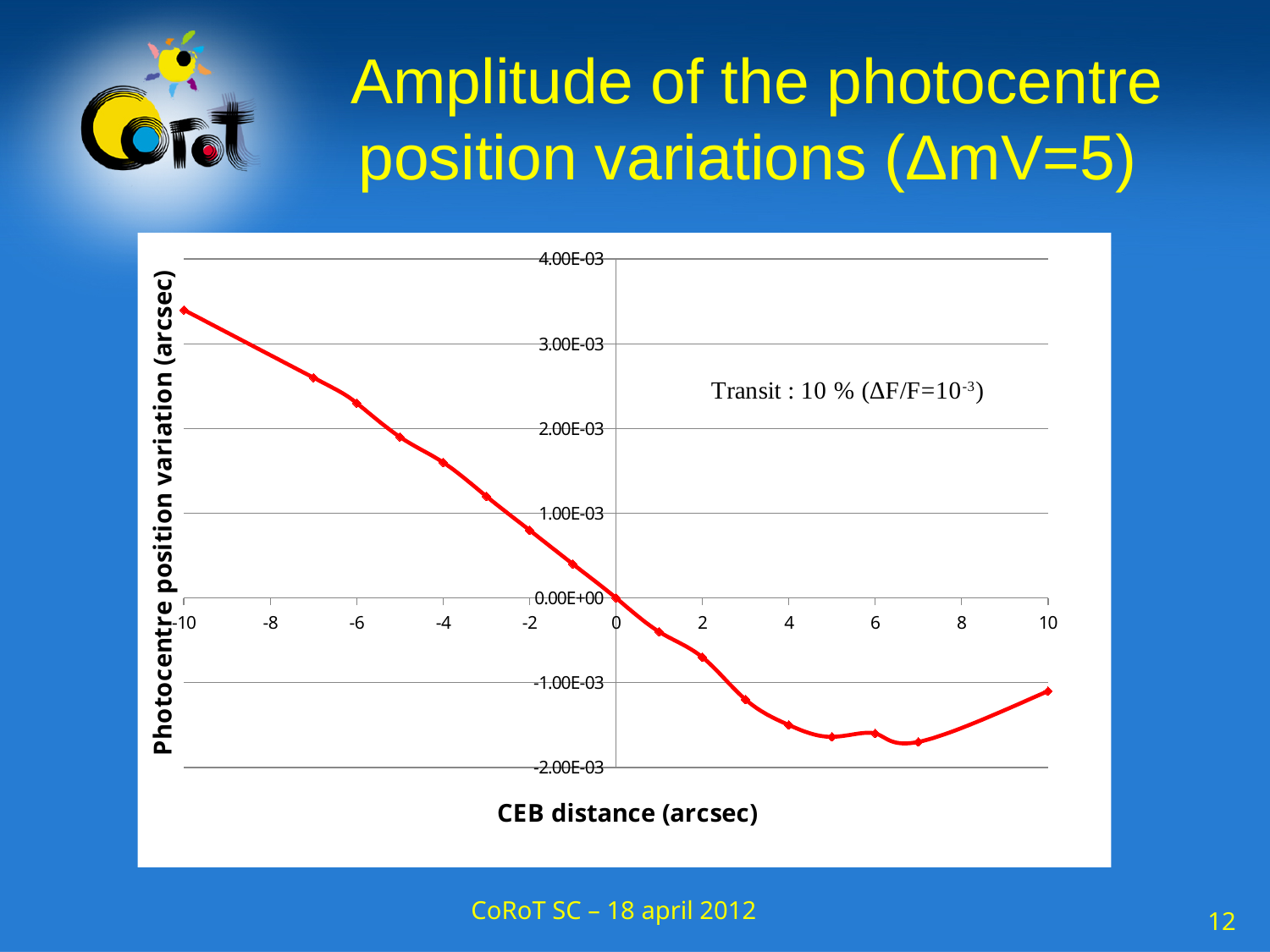
Is the value at a CEB distance of 2 greater or less than -1.00E-03? greater Do the values rise or fall as the CEB distance increases from -10 to 0? fall Is the value at a CEB distance of -6 greater or less than 2.00E-03? greater What is the photocentre position variation at a CEB distance of 0? 0.00E+00 What kind of chart is shown on the slide? line chart Is the value at a CEB distance of 4 greater or less than -1.00E-03? less At which CEB distance is the photocentre position variation highest? -10 Which has the larger photocentre position variation, a CEB distance of -6 or 6? -6 How many data points are plotted on the curve? 17 What is the y-axis title of the chart? Photocentre position variation (arcsec) What is the x-axis title of the chart? CEB distance (arcsec)